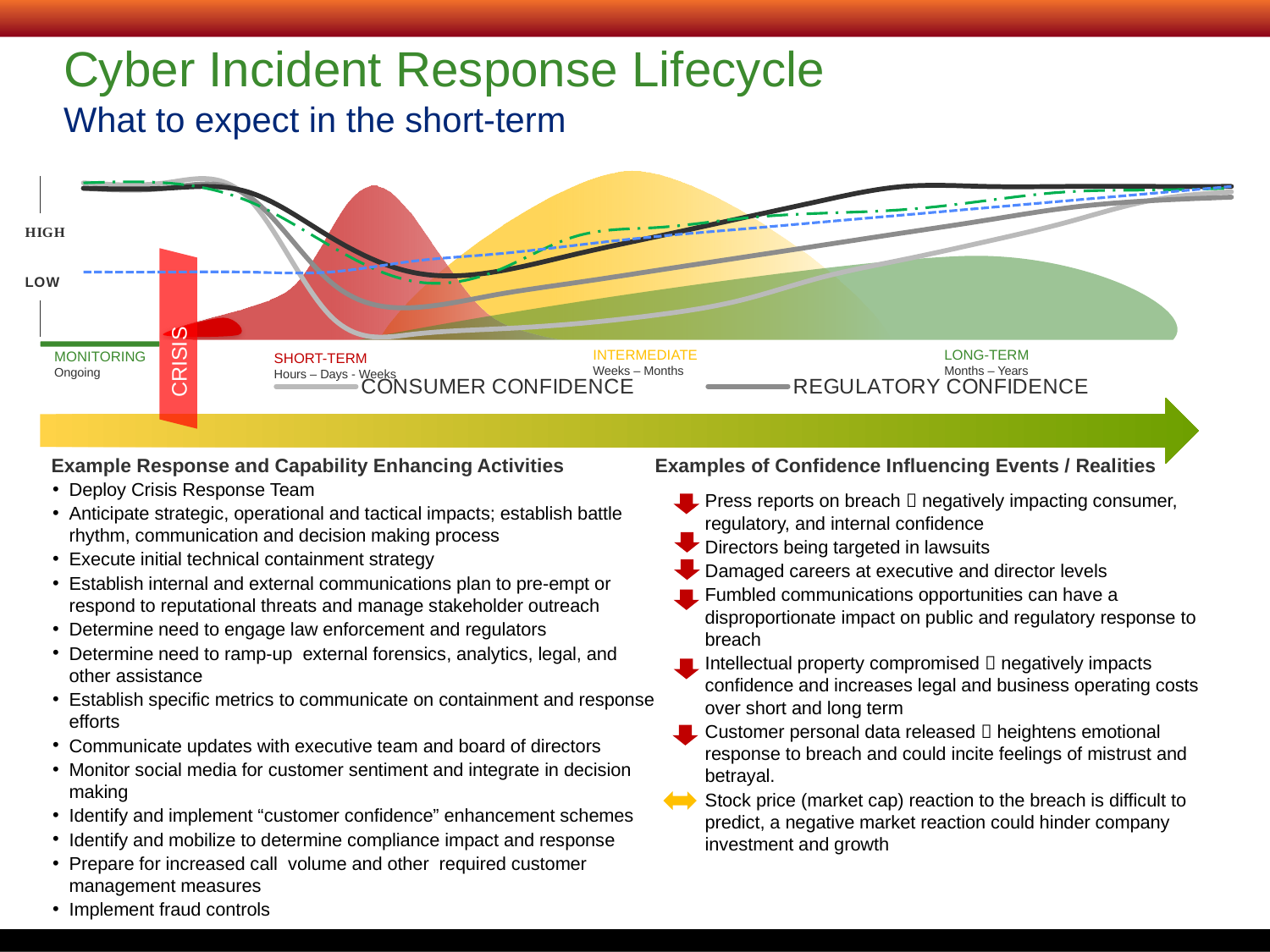
Does the consumer confidence line fall or rise as it moves from the Monitoring phase into the Crisis phase? fall What time frame is given under the SHORT-TERM phase label on the chart? Hours – Days - Weeks How many series does the chart legend list? 2 What kind of chart is shown on the slide? line chart Which two series are named in the chart legend? CONSUMER CONFIDENCE and REGULATORY CONFIDENCE How many phases are labelled along the x axis of the chart (Monitoring through Long-term)? 5 Does the consumer confidence line rise or fall from the Intermediate phase to the Long-term phase? rise